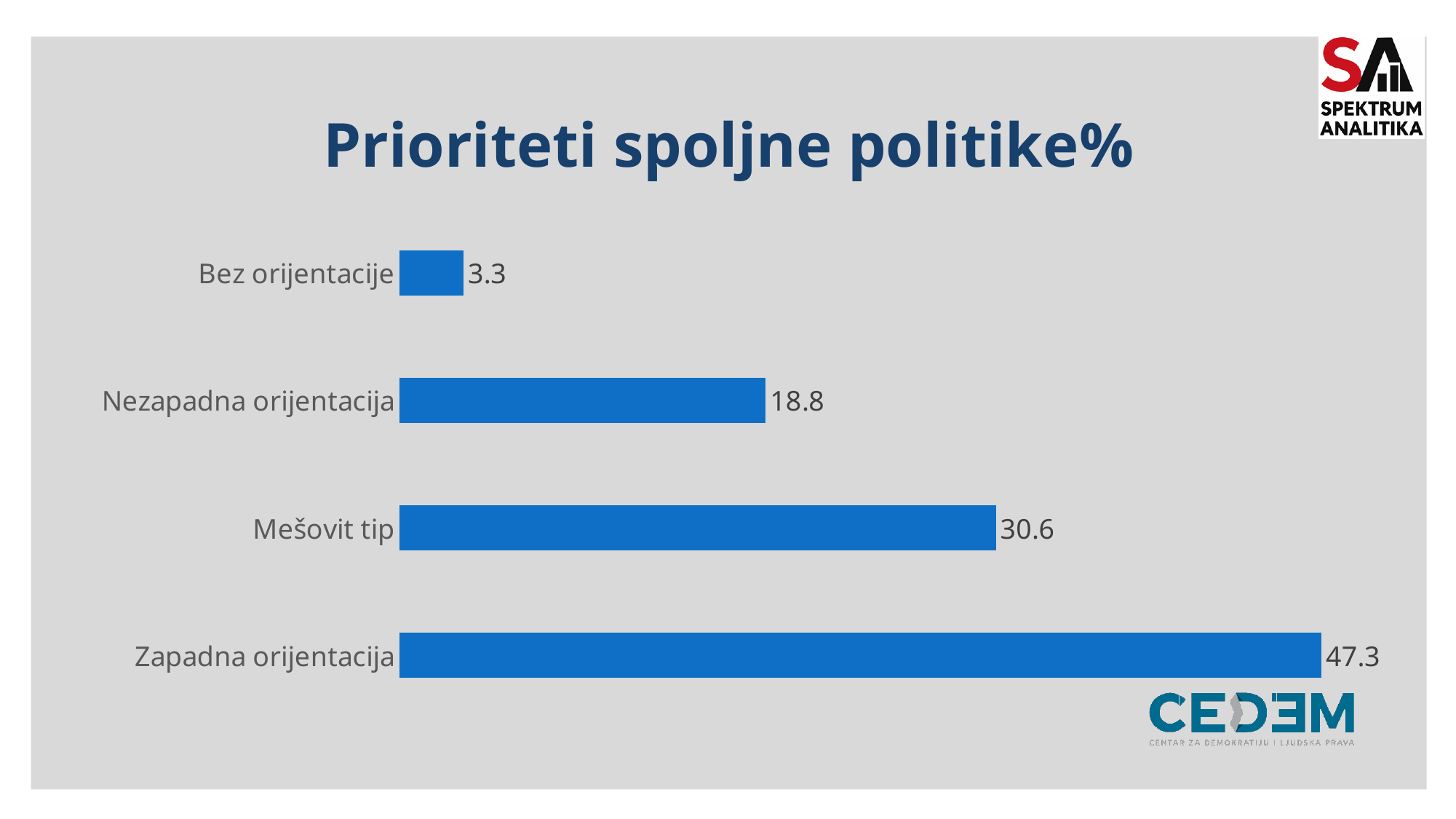
What kind of chart is shown on the slide? Bar chart What is the value for Mešovit tip? 30.6 Which category has the lowest value? Bez orijentacije What is the value for Zapadna orijentacija? 47.3 What is the difference between the values for Zapadna orijentacija and Mešovit tip? 16.7 What is the value for Bez orijentacije? 3.3 How many categories are shown in the chart? 4 What is the difference between the values for Nezapadna orijentacija and Bez orijentacije? 15.5 What is the value for Nezapadna orijentacija? 18.8 Which is larger, the value for Mešovit tip or the value for Nezapadna orijentacija? Mešovit tip What is the title of the chart? Prioriteti spoljne politike% Which category has the highest value? Zapadna orijentacija